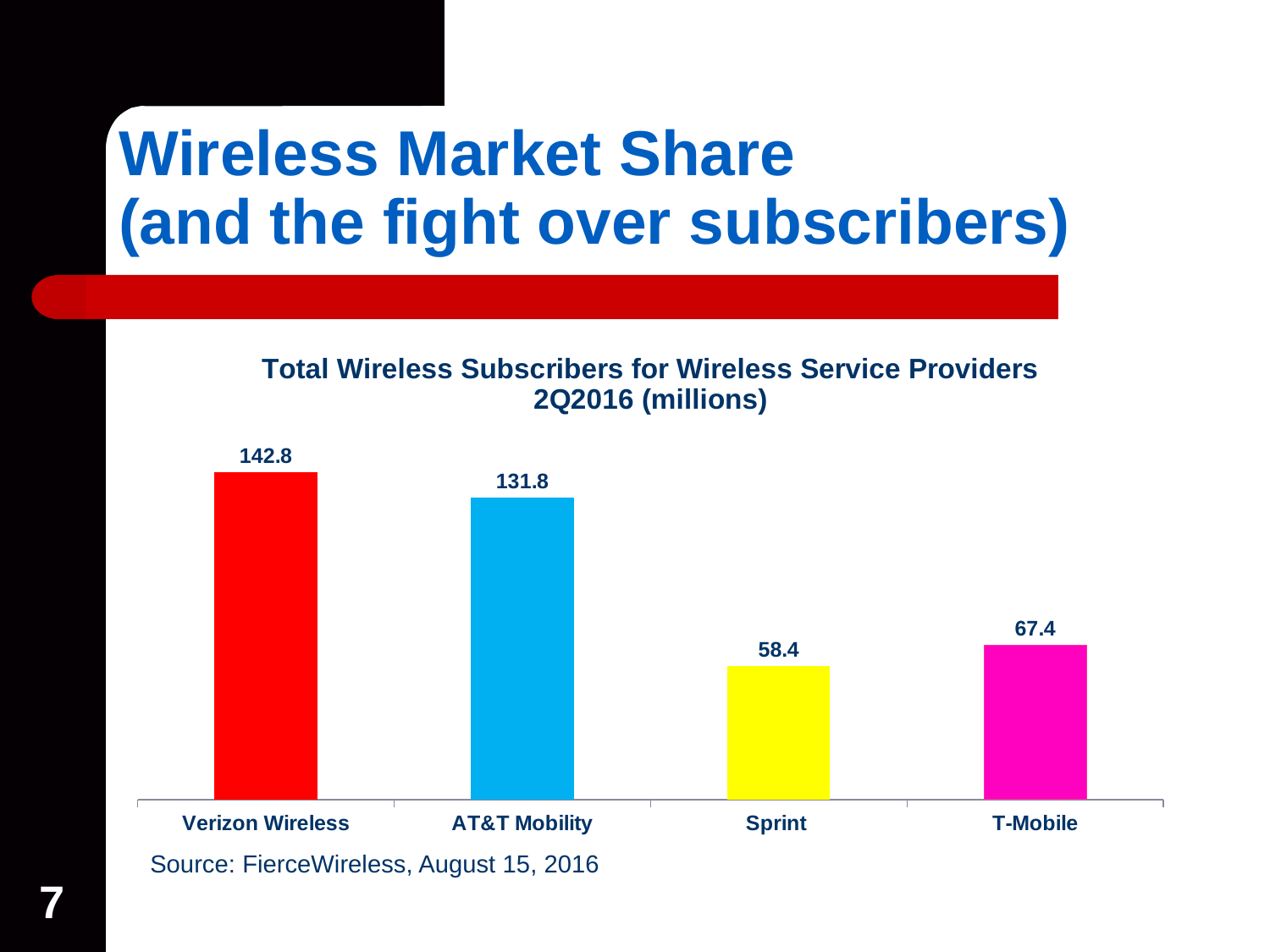
What is the difference between T-Mobile and Sprint? 9.0 What is the value for Verizon Wireless? 142.8 What kind of chart is shown on the slide? Bar chart What is the value for T-Mobile? 67.4 How many providers are shown in the chart? 4 What is the difference between Verizon Wireless and AT&T Mobility? 11.0 Which provider has the lowest number of subscribers? Sprint What is the value for AT&T Mobility? 131.8 What is the value for Sprint? 58.4 Which provider has the highest number of subscribers? Verizon Wireless Which is larger, the value for T-Mobile or the value for Sprint? T-Mobile What is the title of the chart? Total Wireless Subscribers for Wireless Service Providers 2Q2016 (millions)